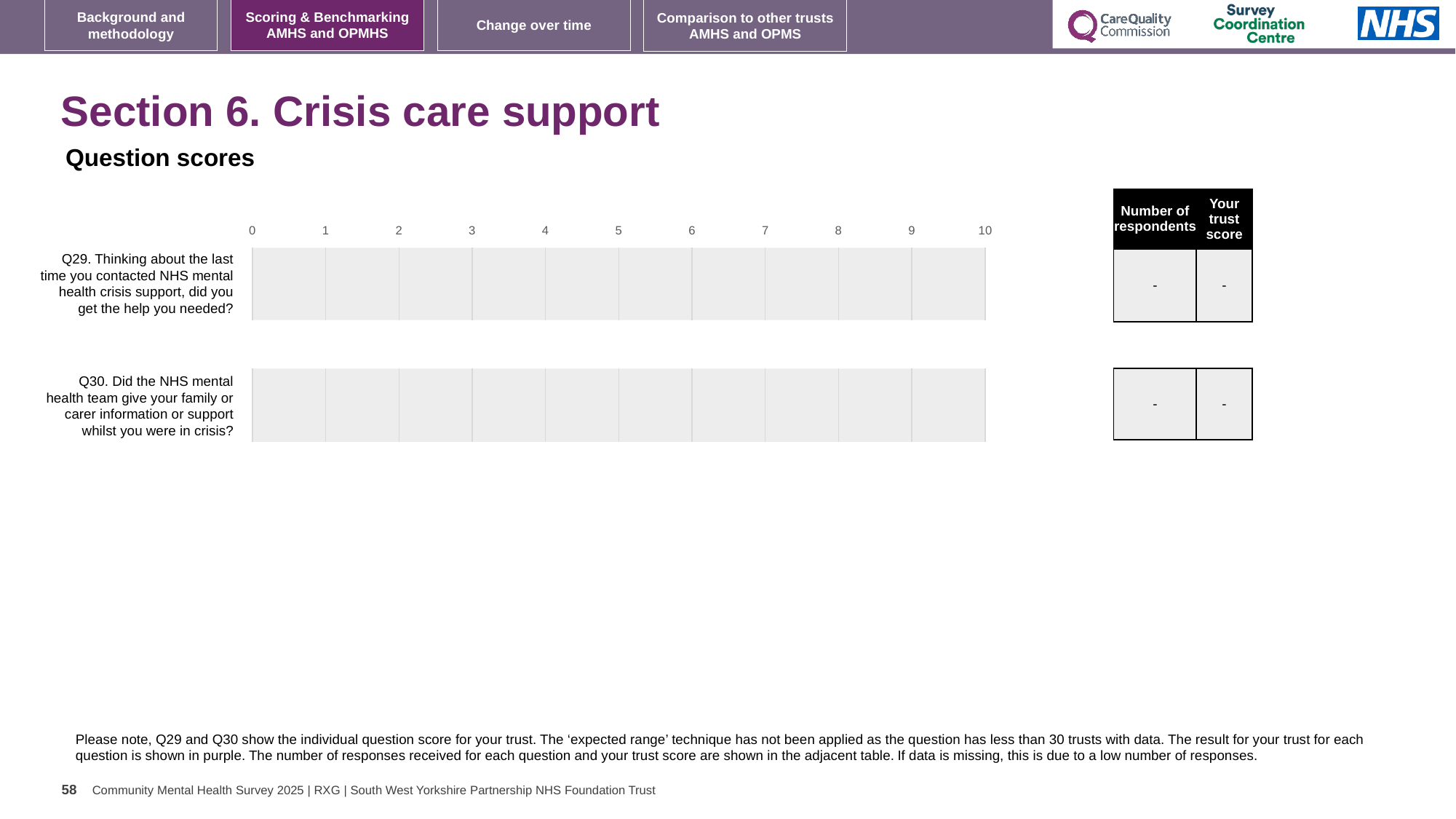
What is the highest value shown on the horizontal axis of the Question scores chart? 10 Which question labels are listed on the Question scores chart? Q29 and Q30 How many questions (categories) are shown on the Question scores chart? 2 What is shown in the 'Number of respondents' column for Q30 in the table next to the chart? - What is shown in the 'Your trust score' column for Q29 in the table next to the chart? - What is the lowest value shown on the horizontal axis of the Question scores chart? 0